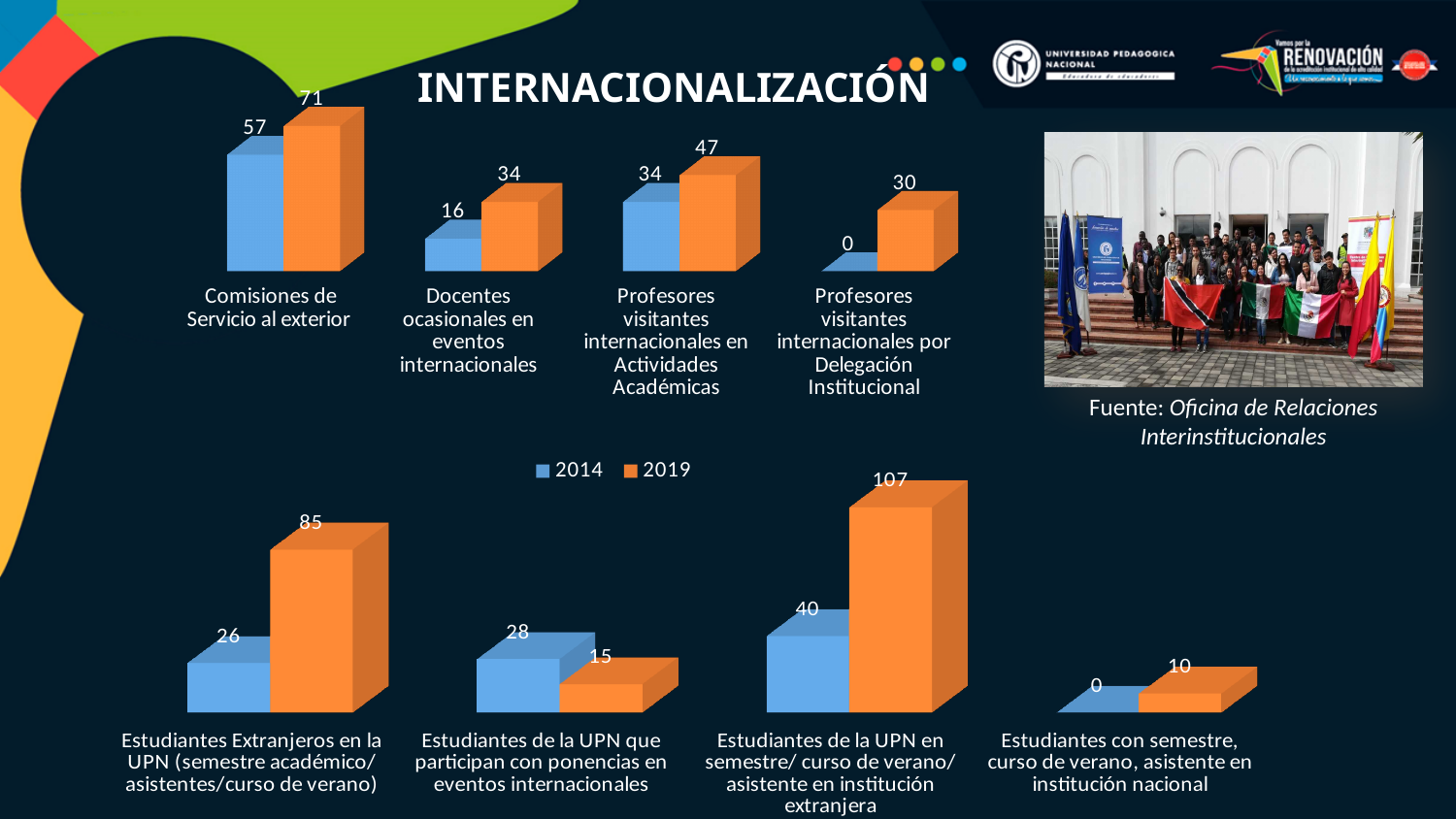
In the bottom chart, what is the difference between the 2019 and 2014 values for Estudiantes Extranjeros en la UPN? 59 How many categories does the bottom chart show? 4 In the top chart, what is the 2019 value for Comisiones de Servicio al exterior? 71 In the bottom chart, what is the 2019 value for Estudiantes de la UPN en semestre/ curso de verano/ asistente en institución extranjera? 107 In the top chart, which category has the highest 2019 value? Comisiones de Servicio al exterior In the top chart, what is the 2014 value for Docentes ocasionales en eventos internacionales? 16 In the bottom chart, what is the 2014 value for Estudiantes Extranjeros en la UPN (semestre académico/ asistentes/curso de verano)? 26 In the top chart, what is the difference between the 2019 and 2014 values for Profesores visitantes internacionales en Actividades Académicas? 13 How many series does the legend list? 2 In the top chart, what is the 2014 value for Profesores visitantes internacionales por Delegación Institucional? 0 In the bottom chart, which category has the lowest 2019 value? Estudiantes con semestre, curso de verano, asistente en institución nacional In the bottom chart, is the 2014 or the 2019 value larger for Estudiantes de la UPN que participan con ponencias en eventos internacionales? 2014